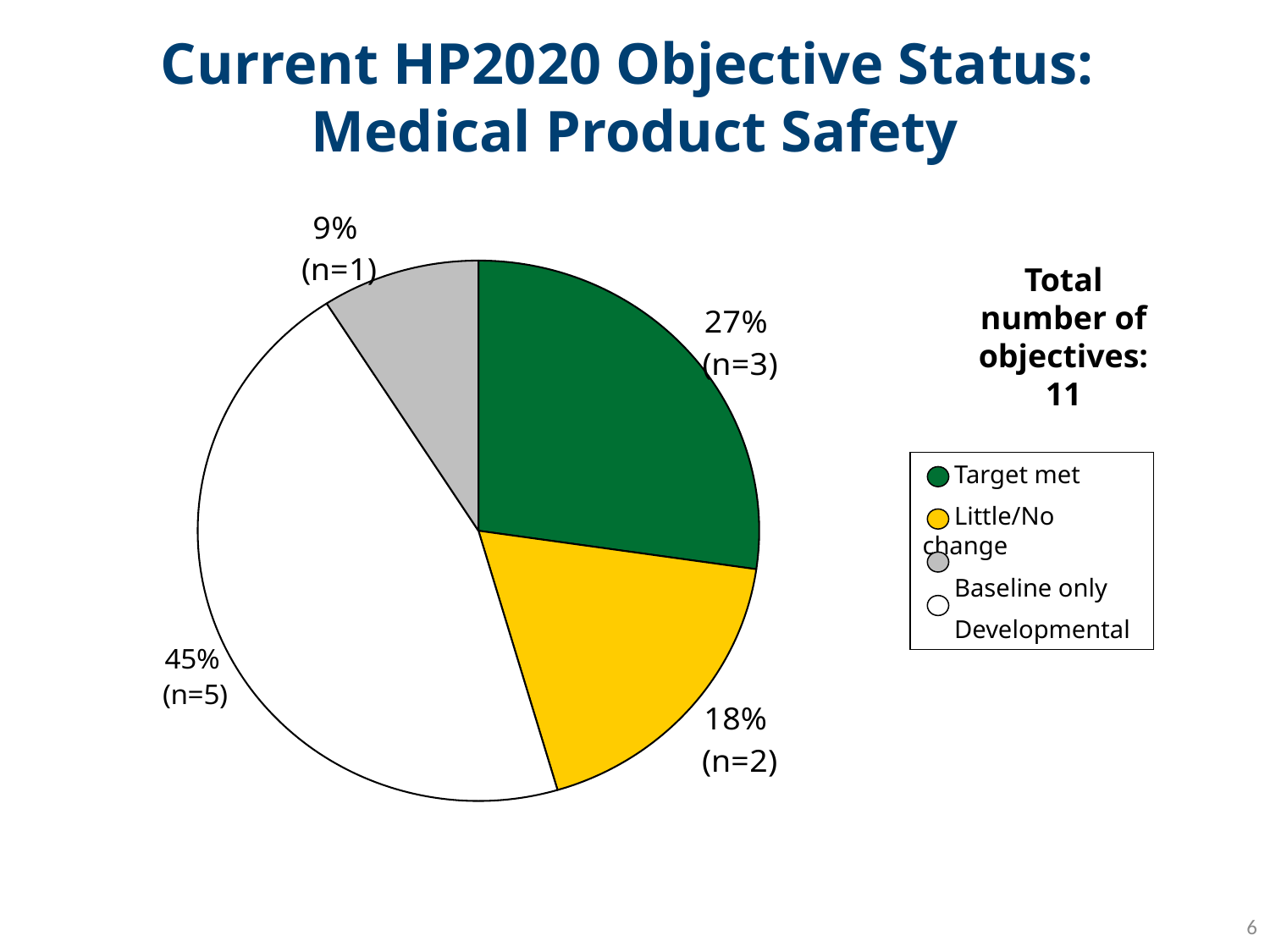
What colour is the Little/No change slice? Yellow Which slice is larger, Target met or Little/No change? Target met Which category has the largest share of the pie? Developmental What is the total number of objectives stated on the slide? 11 How many categories does the pie chart have? 4 What is the difference in percentage points between the Developmental and Target met slices? 18 What percentage of objectives is shown for the Baseline only slice? 9% What percentage of objectives is shown for the Target met slice? 27% Which category has the smallest share of the pie? Baseline only How many objectives (n) are in the Little/No change slice? 2 How many objectives (n) are in the Developmental slice? 5 What type of chart is shown on the slide? Pie chart